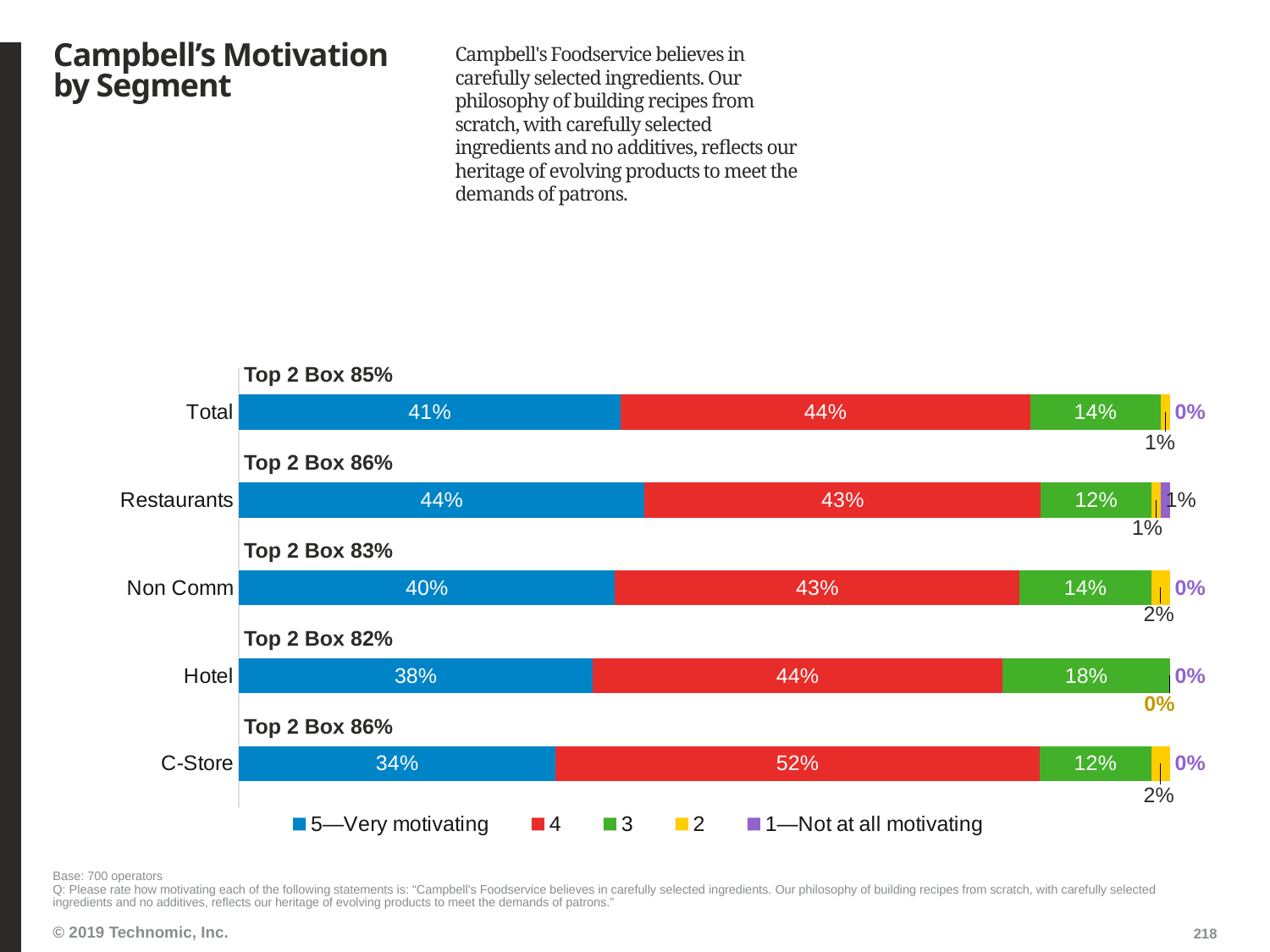
What is the difference between the 5—Very motivating share for Total and for C-Store? 7 percentage points What percentage of Restaurants operators gave a rating of 3? 12% How many segments are shown in the chart? 5 Is the share of 4 ratings larger for C-Store or for Hotel? C-Store What percentage of Hotel operators rated the statement 5—Very motivating? 38% What type of chart is shown on the slide? Stacked bar chart Which segment has the highest share of ratings of 3? Hotel How many series does the legend list? 5 Which segment has the highest share of 5—Very motivating ratings? Restaurants What is the Top 2 Box score for Non Comm? 83% Which segment has the lowest share of 5—Very motivating ratings? C-Store What percentage of C-Store operators gave a rating of 4? 52%